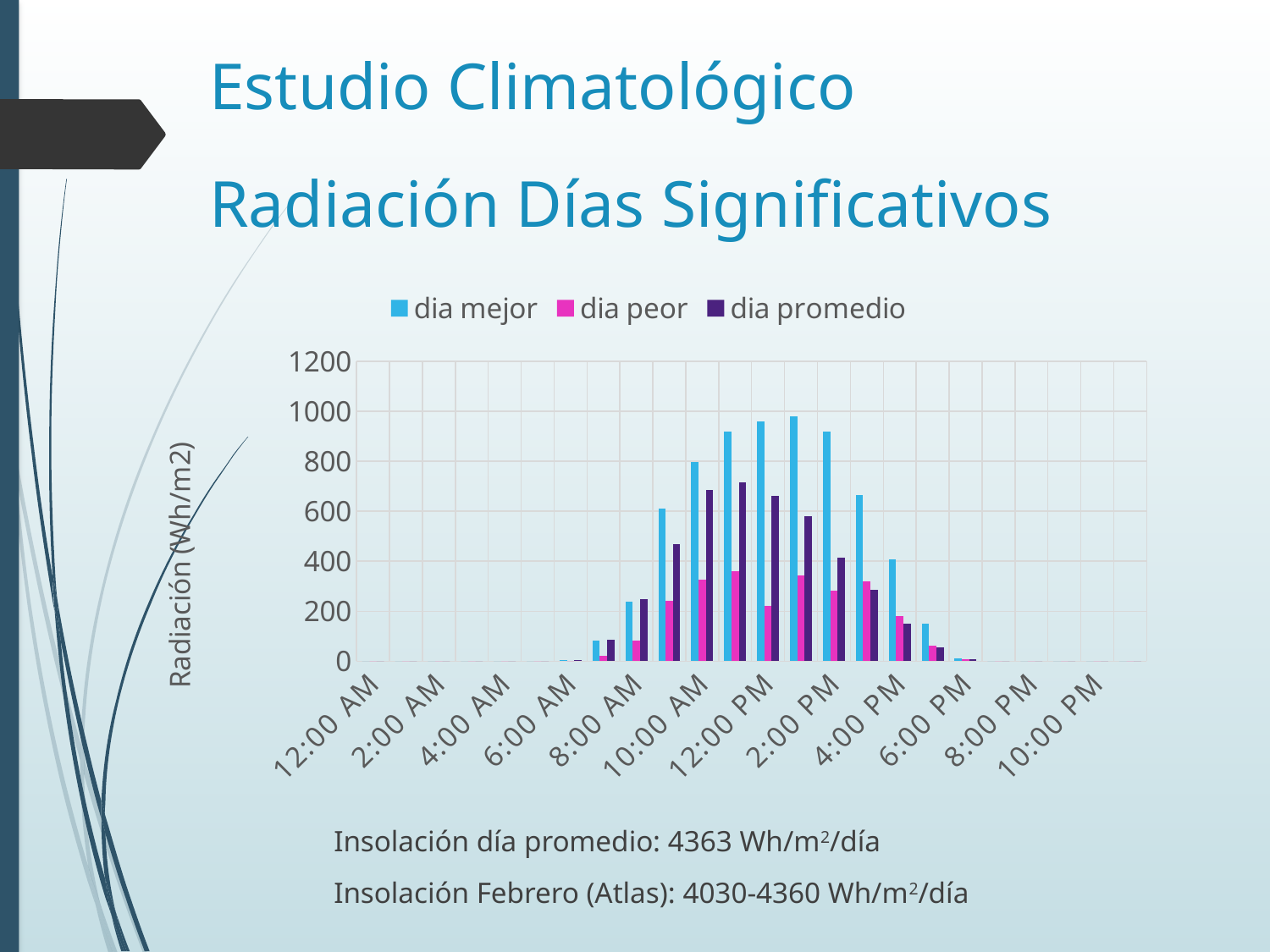
Is the highest value for dia promedio greater or less than 800? less How many series does the legend list? 3 Which series has the lowest values on the chart? dia peor Do the dia mejor values rise or fall from 6:00 AM to 12:00 PM? rise What kind of chart is shown on the slide? bar chart How many time labels are shown on the x axis? 12 Is the value for dia mejor at 12:00 AM greater or less than 200? less What are the three series named in the legend? dia mejor, dia peor, dia promedio Is the highest value for dia mejor greater or less than 800? greater Which series reaches the highest values on the chart? dia mejor What is the label on the vertical axis? Radiación (Wh/m2)